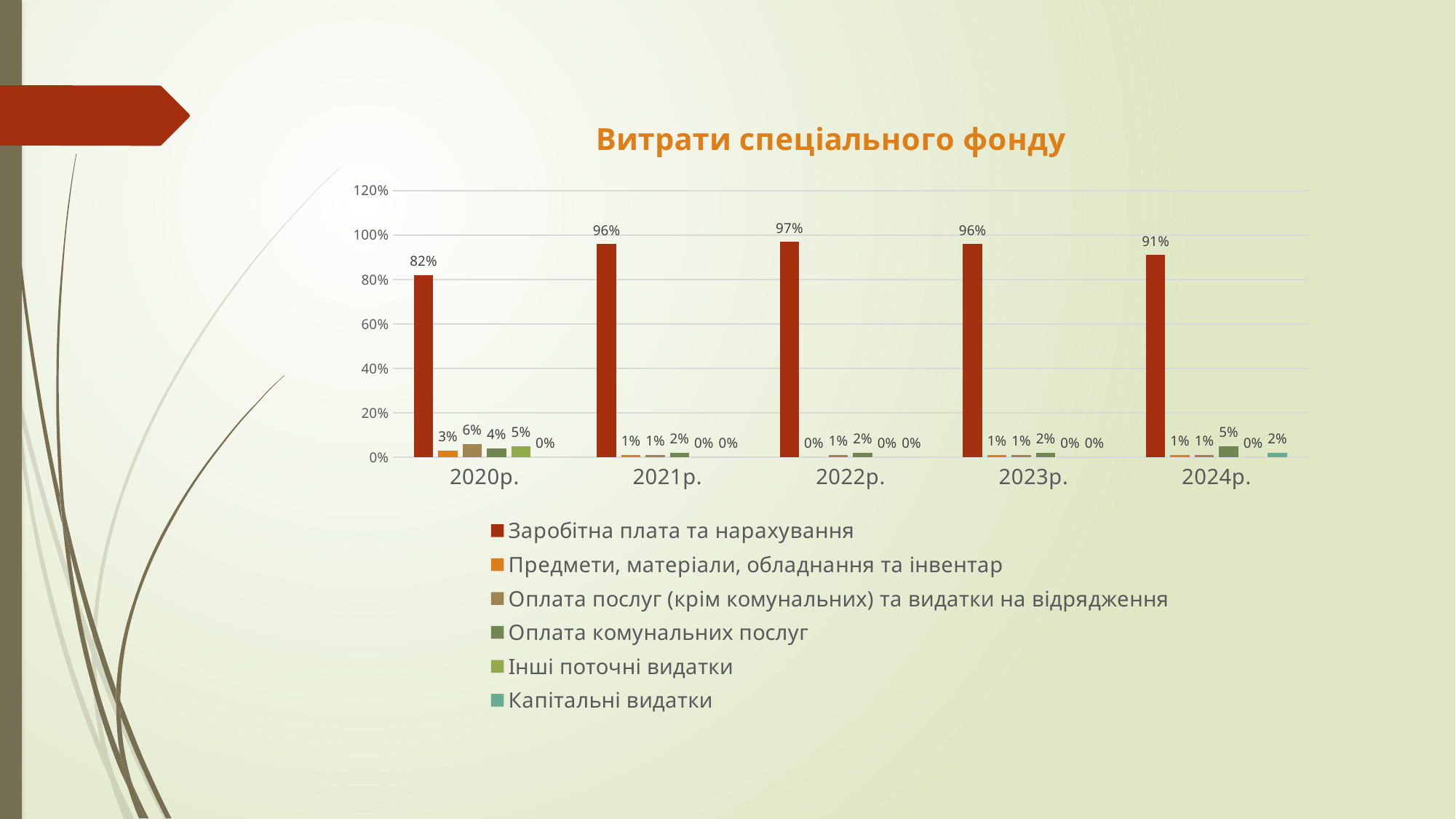
What is the difference between Заробітна плата та нарахування in 2022р. and in 2024р.? 6% What is the value for Інші поточні видатки in 2020р.? 5% In which year is Заробітна плата та нарахування highest? 2022р. How many year categories are shown on the x axis? 5 In which year is Заробітна плата та нарахування lowest? 2020р. What is the title of the chart? Витрати спеціального фонду What is the value for Оплата комунальних послуг in 2024р.? 5% What is the value for Заробітна плата та нарахування in 2020р.? 82% What is the value for Оплата послуг (крім комунальних) та видатки на відрядження in 2020р.? 6% What type of chart is shown on the slide? Bar chart Which is larger: Капітальні видатки in 2024р. or Капітальні видатки in 2023р.? 2024р. How many series does the legend list? 6